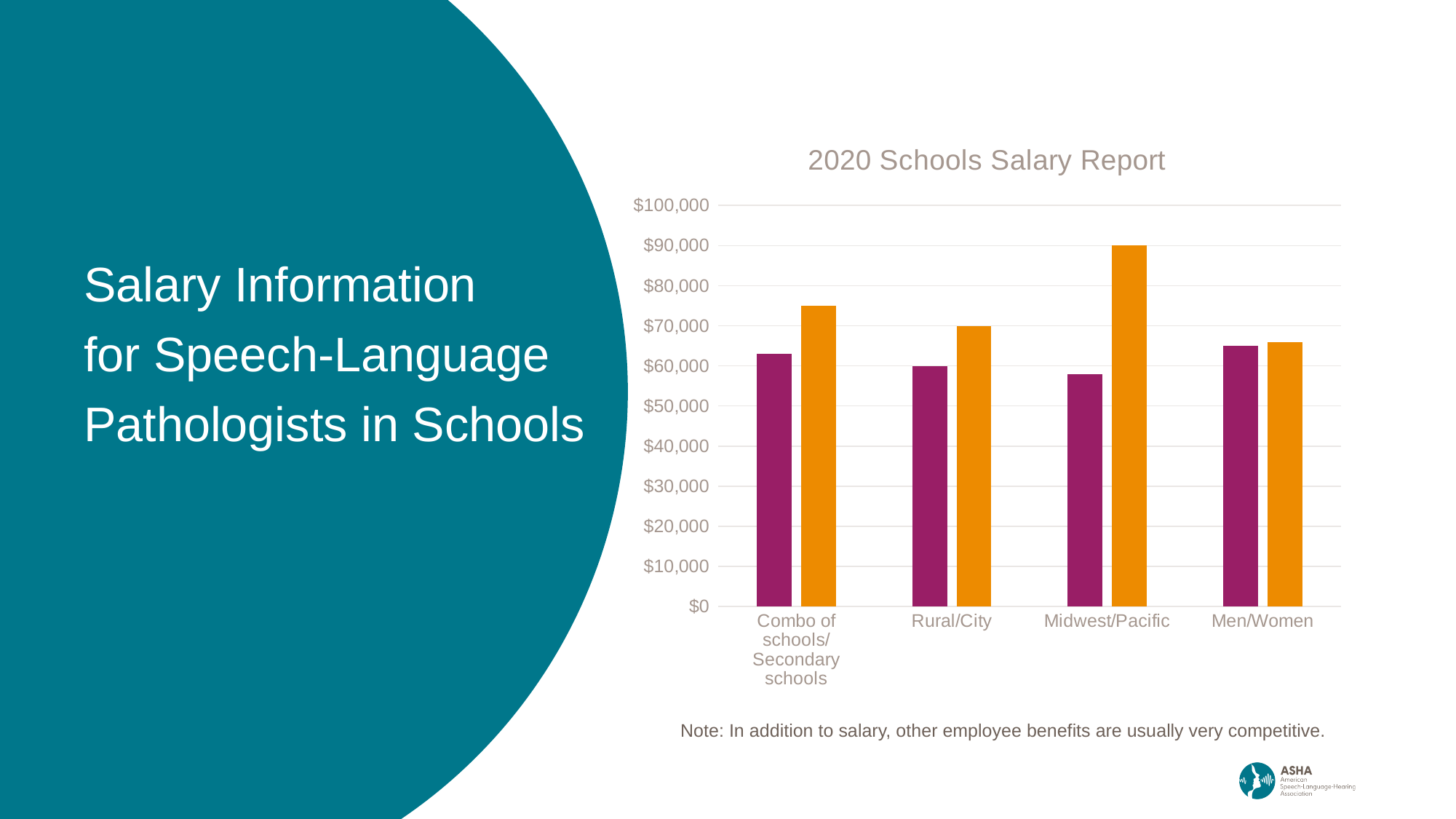
How many bars are plotted for each category in the chart? 2 Which is larger: the orange bar for Combo of schools/Secondary schools or the orange bar for Rural/City? Combo of schools/Secondary schools What is the value of the purple bar for Rural/City? $60,000 Is the value of the orange bar for Combo of schools/Secondary schools greater or less than $70,000? greater What kind of chart is shown on the slide? bar chart Which category has the tallest bar in the chart? Midwest/Pacific What is the value of the orange bar for Midwest/Pacific? $90,000 What is the title of the chart? 2020 Schools Salary Report How many categories are shown on the x axis of the chart? 4 What is the value of the orange bar for Rural/City? $70,000 Is the value of the orange bar for Men/Women greater or less than $70,000? less Is the value of the purple bar for Midwest/Pacific greater or less than $60,000? less